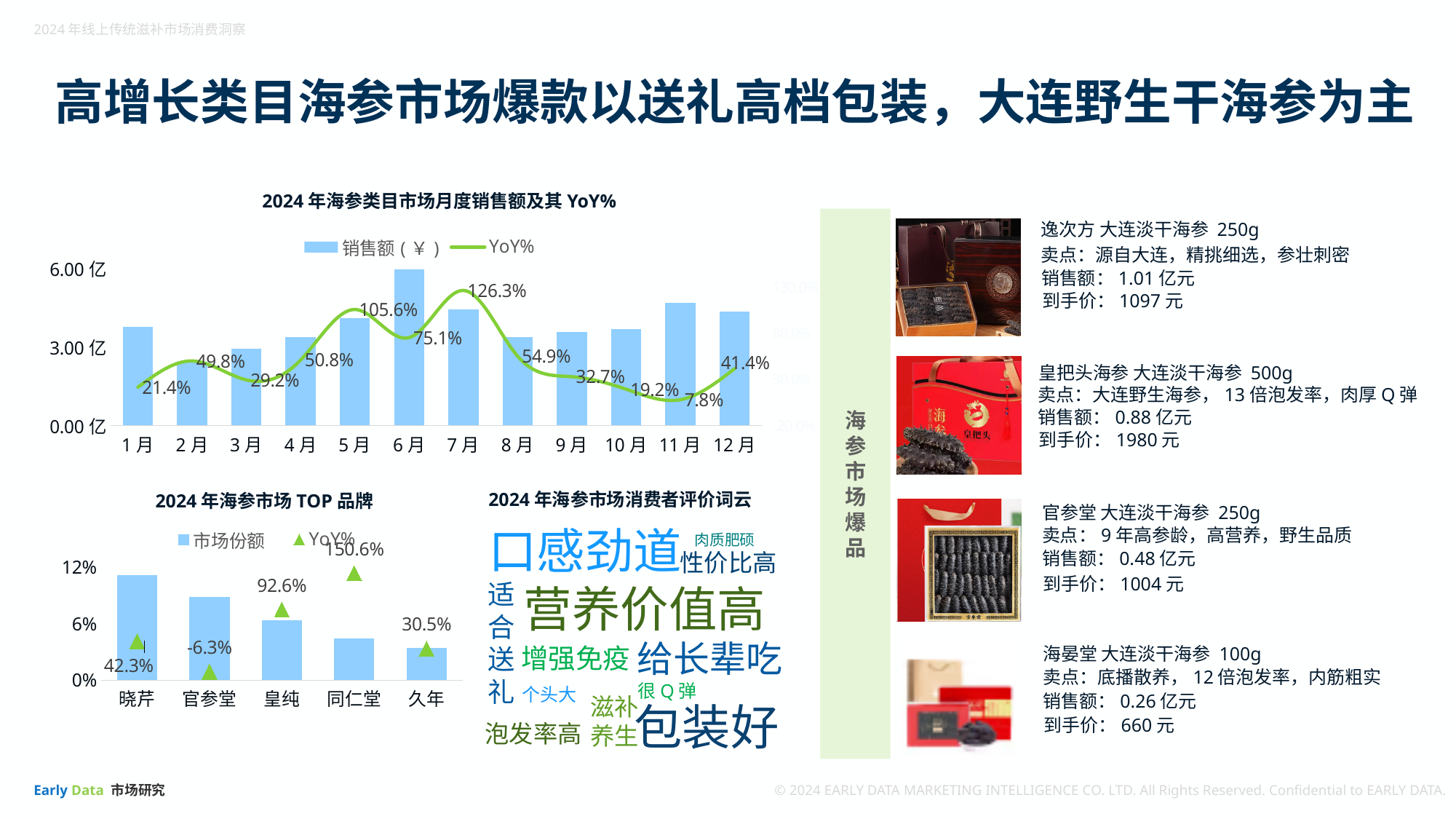
In the chart '2024年海参市场TOP品牌', which brand has the largest 市场份额 bar? 晓芹 In the chart '2024年海参类目市场月度销售额及其YoY%', which month has the highest YoY%? 7月 In the chart '2024年海参类目市场月度销售额及其YoY%', what is the YoY% value for 11月? 7.8% In the chart '2024年海参市场TOP品牌', what is the YoY% value for 同仁堂? 150.6% In the chart '2024年海参类目市场月度销售额及其YoY%', which month has the lowest YoY%? 11月 In the chart '2024年海参类目市场月度销售额及其YoY%', what is the YoY% value for 7月? 126.3% In the chart '2024年海参类目市场月度销售额及其YoY%', how many months are shown on the x axis? 12 In the chart '2024年海参类目市场月度销售额及其YoY%', is the 销售额 bar for 6月 greater or less than 3.00亿? greater In the chart '2024年海参类目市场月度销售额及其YoY%', what is the difference between the YoY% for 5月 and 4月? 54.8% In the chart '2024年海参类目市场月度销售额及其YoY%', which month has the tallest 销售额 bar? 6月 In the chart '2024年海参市场TOP品牌', how many series does the legend list? 2 In the chart '2024年海参市场TOP品牌', which brand has a negative YoY%? 官参堂